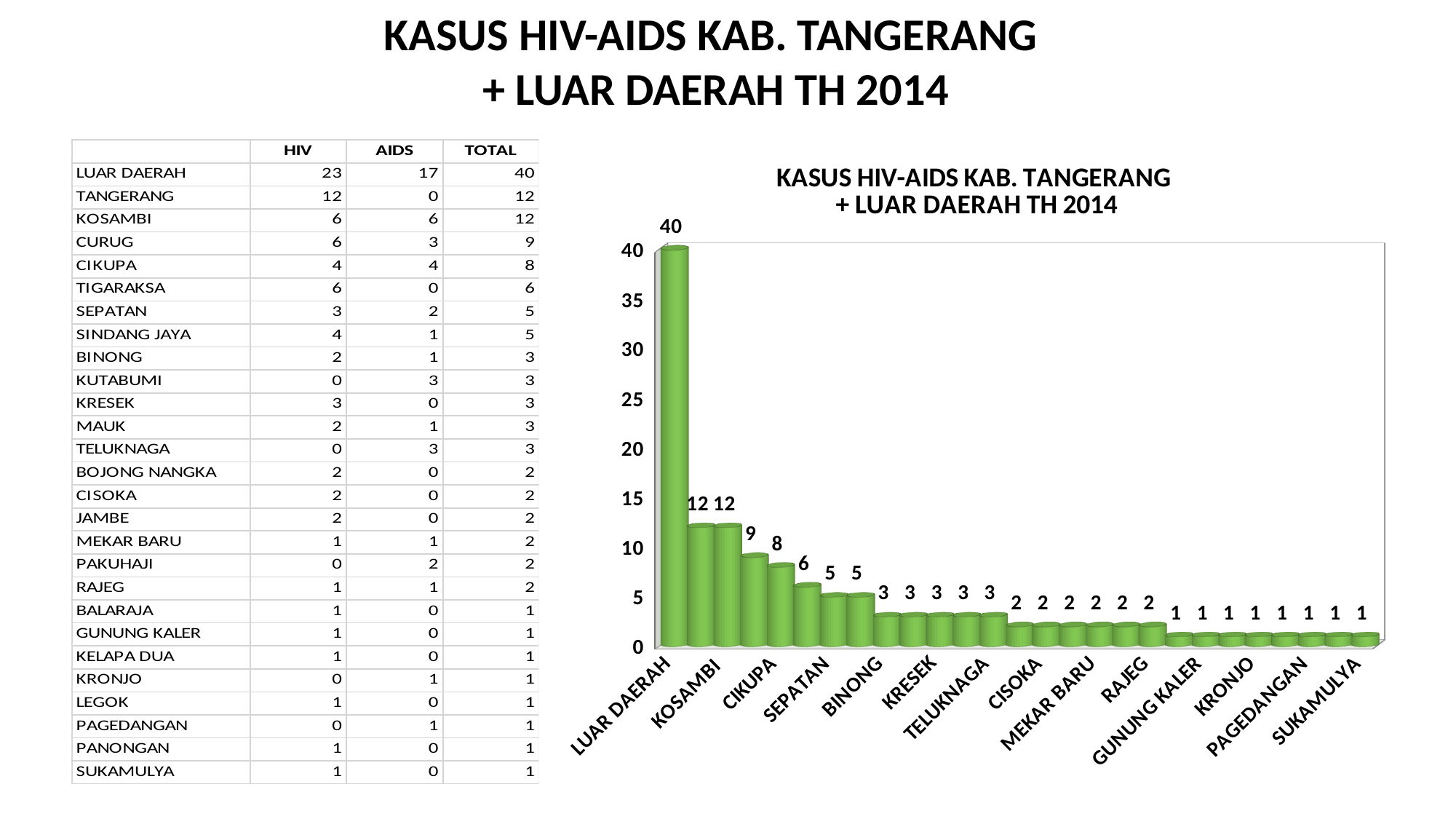
Is the value for LUAR DAERAH greater or less than 35? greater What kind of chart is shown on the slide? bar chart Which is larger, the value for KOSAMBI or the value for CIKUPA? KOSAMBI What is the value for CISOKA in the chart? 2 What is the title of the chart? KASUS HIV-AIDS KAB. TANGERANG + LUAR DAERAH TH 2014 What is the value for CIKUPA in the chart? 8 Do the values rise or fall from left to right along the x axis? fall Which category has the highest value in the chart? LUAR DAERAH What is the value for SEPATAN in the chart? 5 What is the value for LUAR DAERAH in the chart? 40 What is the difference between the values for LUAR DAERAH and KOSAMBI? 28 What is the value for KOSAMBI in the chart? 12